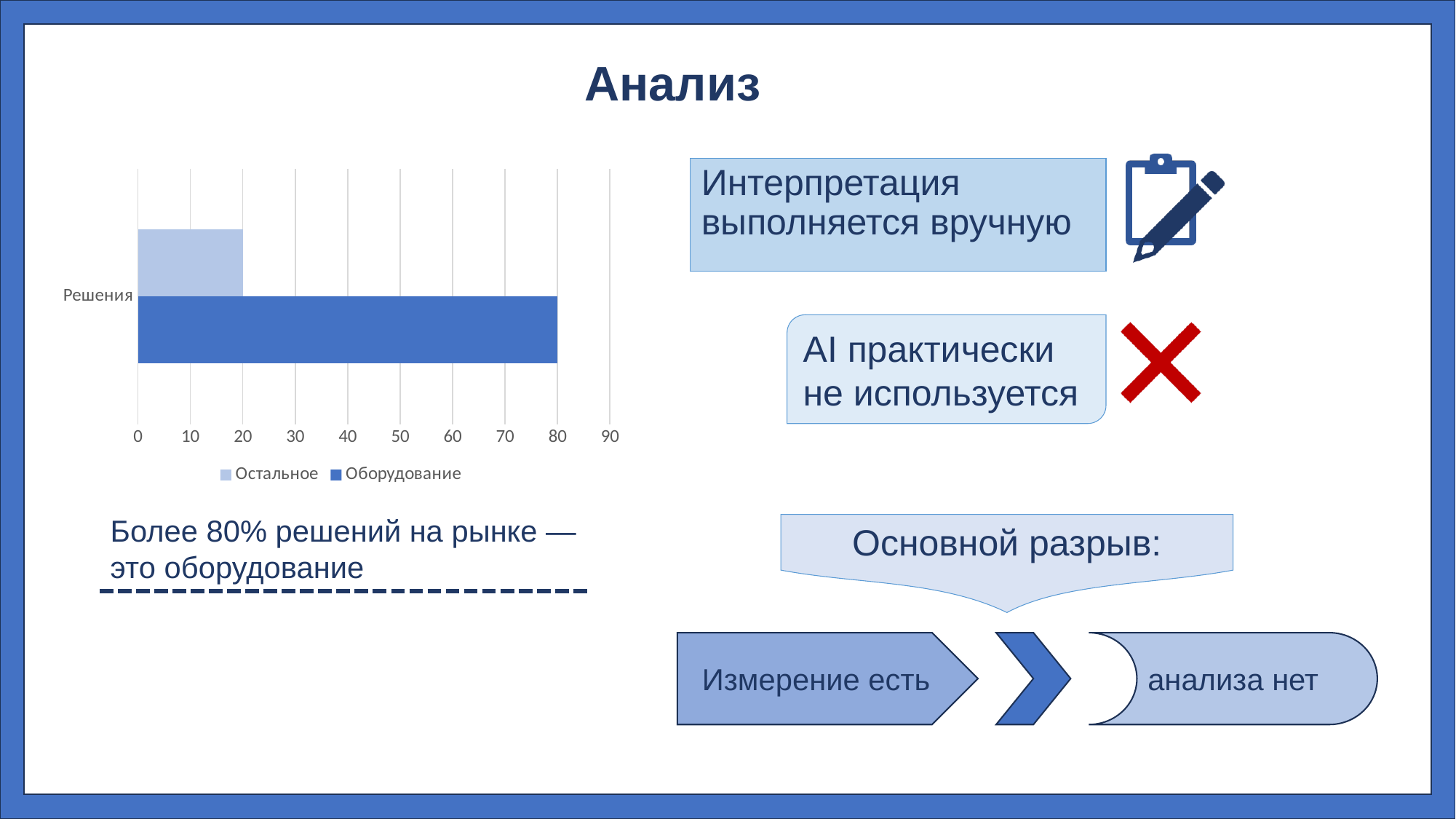
What is the difference between the Оборудование and Остальное values for Решения? 60 What is the value of the Оборудование bar for Решения? 80 Is the value of the Оборудование bar greater or less than 50? greater Which series has the larger value for Решения, Остальное or Оборудование? Оборудование What is the highest value shown on the chart's horizontal axis? 90 What is the value of the Остальное bar for Решения? 20 What are the two series named in the chart legend? Остальное and Оборудование What kind of chart is shown on the slide? bar chart How many series does the chart legend list? 2 Is the value of the Остальное bar greater or less than 30? less How many categories are shown on the chart's vertical axis? 1 Which series has the smallest value in the chart? Остальное